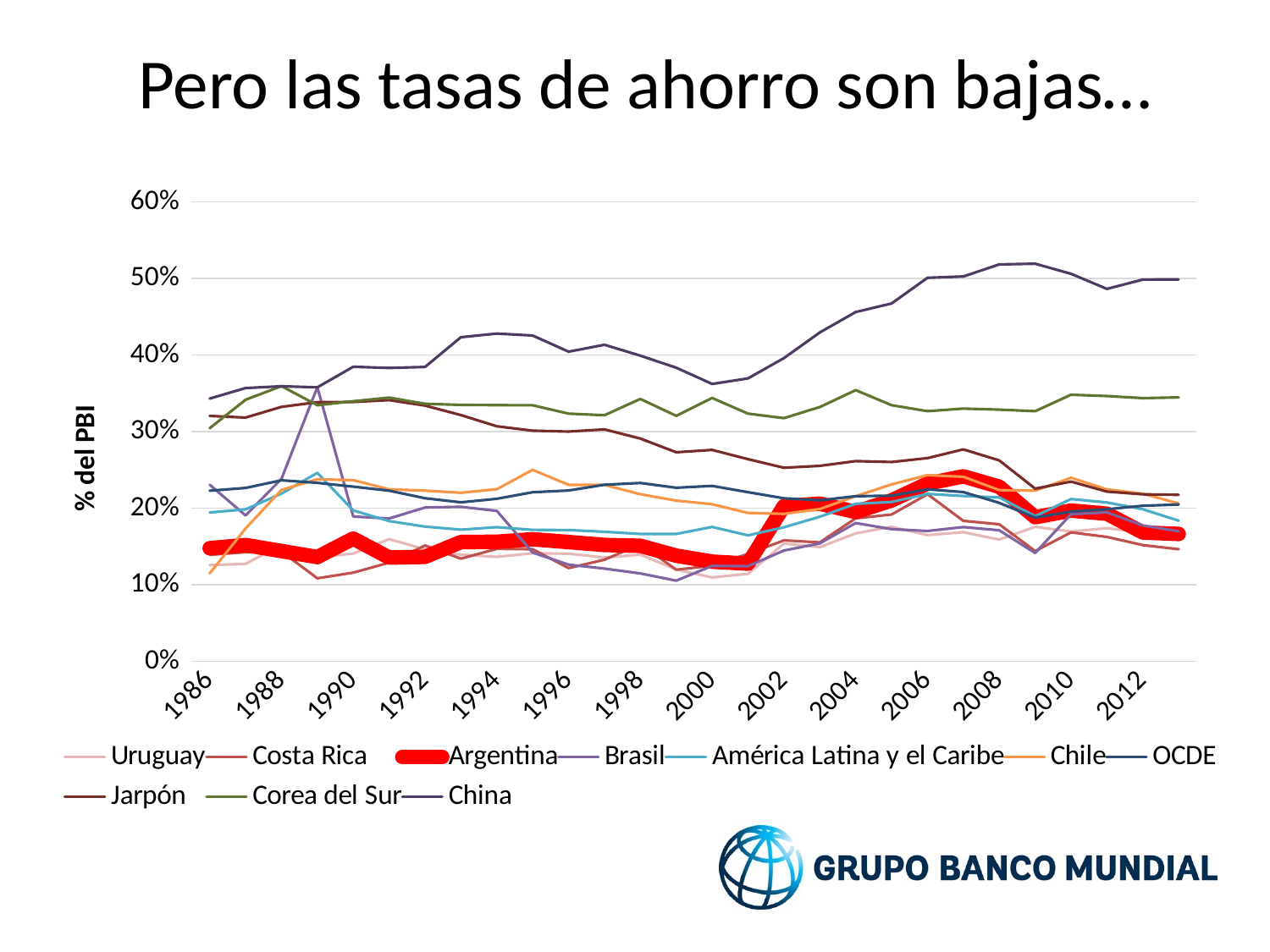
Which is larger in 2010, the value for China or the value for Argentina? China Which series has the highest value in 2012? China How many series does the legend list? 10 What is the title of the chart? Pero las tasas de ahorro son bajas… Is the value for Corea del Sur in 2012 greater or less than 30%? greater Which series is drawn with the thick red line? Argentina Which series has the highest value in 2004? China Is the value for Argentina in 1986 greater or less than 20%? less Is the value for Chile in 1986 greater or less than 20%? less What kind of chart is shown on the slide? line chart Does the value for China rise or fall from 2000 to 2008? rise